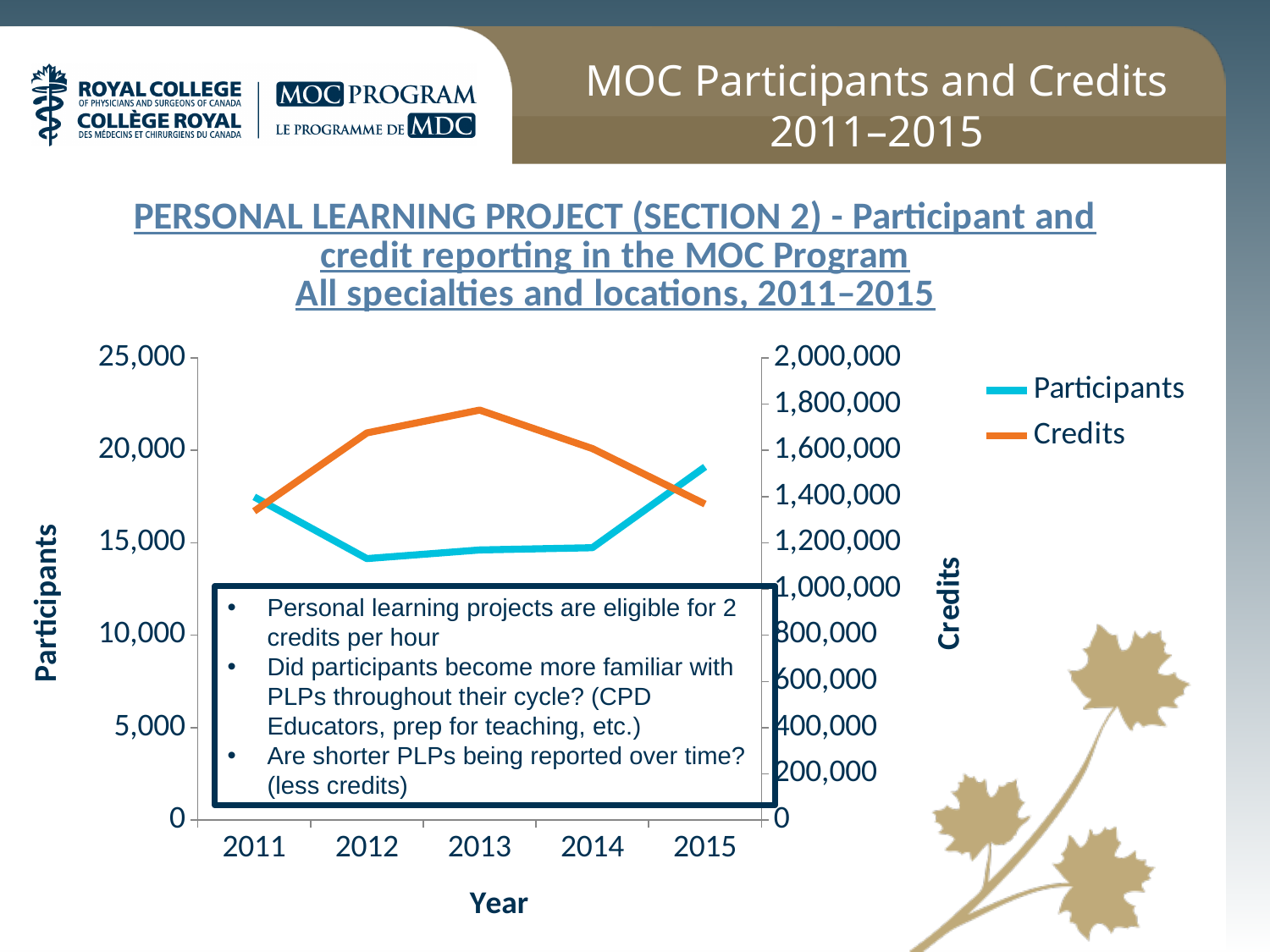
Is the value for Credits in 2013 greater or less than 1,600,000? greater In which year is the Credits line at its highest? 2013 Do Credits rise or fall from 2013 to 2015? fall In which year is the Participants line at its highest? 2015 Is the value for Participants in 2015 greater or less than 15,000? greater How many series does the chart legend list? 2 Is the value for Credits in 2011 greater or less than 1,600,000? less What kind of chart is shown on the slide? line chart How many years are plotted along the x axis of the chart? 5 What is the title of the x axis of the chart? Year Which year has more Participants, 2011 or 2015? 2015